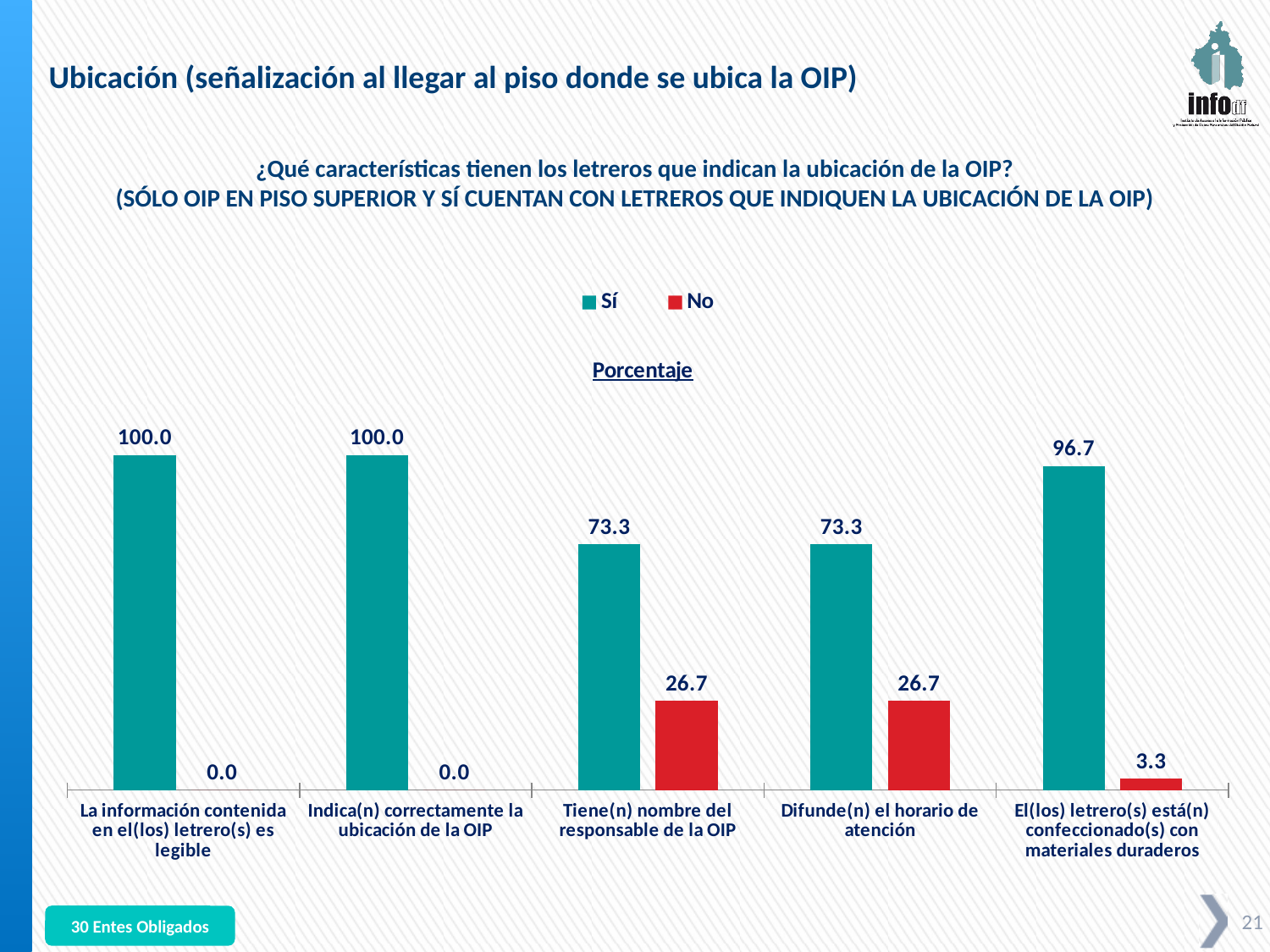
Which category has the lowest 'Sí' value? Tiene(n) nombre del responsable de la OIP and Difunde(n) el horario de atención (both 73.3) What kind of chart is shown on the slide? Bar chart Which category has the highest 'No' value? Tiene(n) nombre del responsable de la OIP and Difunde(n) el horario de atención (both 26.7) What is the 'Sí' value for 'Tiene(n) nombre del responsable de la OIP'? 73.3 What is the 'Sí' value for 'El(los) letrero(s) está(n) confeccionado(s) con materiales duraderos'? 96.7 Which colour represents the 'No' series in the chart? Red What is the difference between the 'Sí' and 'No' values for 'Difunde(n) el horario de atención'? 46.6 How many series does the legend list? 2 How many categories are shown on the x axis of the chart? 5 What is the 'No' value for 'Difunde(n) el horario de atención'? 26.7 Which is larger: the 'Sí' value for 'Indica(n) correctamente la ubicación de la OIP' or the 'Sí' value for 'El(los) letrero(s) está(n) confeccionado(s) con materiales duraderos'? Indica(n) correctamente la ubicación de la OIP What is the 'No' value for 'El(los) letrero(s) está(n) confeccionado(s) con materiales duraderos'? 3.3